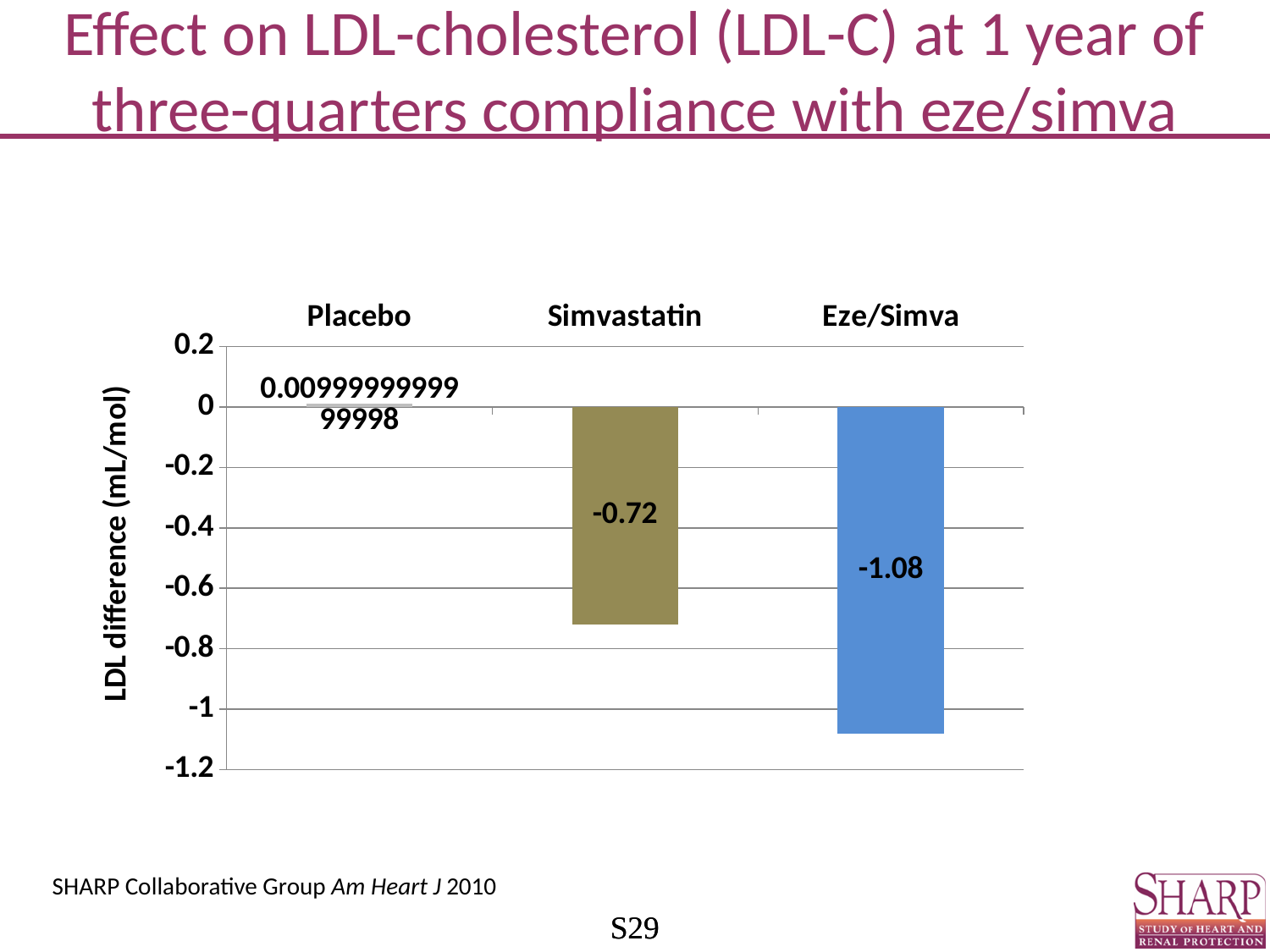
Do the values rise or fall moving from Placebo to Eze/Simva along the x axis? fall Which has a larger LDL reduction, Simvastatin or Eze/Simva? Eze/Simva What is the difference between the Simvastatin and Eze/Simva values? 0.36 How many categories are shown in the chart? 3 Which category has the highest LDL difference value? Placebo Is the value for Simvastatin greater or less than -0.8? greater What kind of chart is shown on the slide? bar chart Is the value for Eze/Simva greater or less than -1? less What is the LDL difference value for Simvastatin? -0.72 Which category has the lowest LDL difference value? Eze/Simva What is the LDL difference value for Eze/Simva? -1.08 What is the label on the vertical axis of the chart? LDL difference (mL/mol)